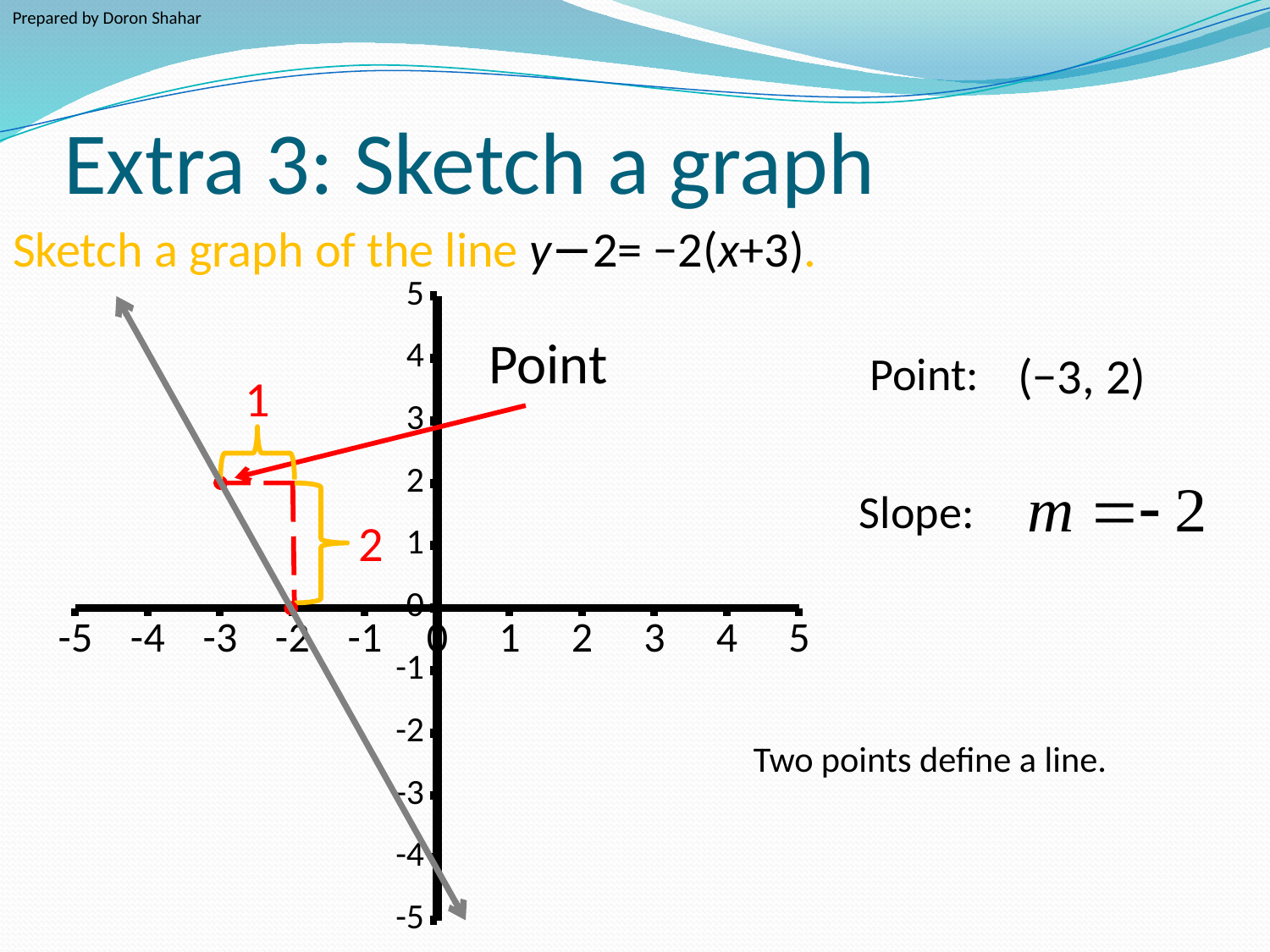
What is the slope of the line shown on the graph? m = −2 What is the range of values shown on the x-axis? −5 to 5 What kind of chart is shown on the slide? line graph At what x-value does the line cross the x-axis? −2 At x = −4, is the line's y-value greater or less than 3? greater Does the line rise or fall as x increases? falls At x = 0, is the line's y-value greater or less than 0? less What are the coordinates of the point labeled on the graph? (−3, 2) What number labels the horizontal run shown next to the marked point? 1 What is the y-value of the marked point at x = −3? 2 What number labels the vertical rise shown next to the marked point? 2 What is the equation of the line being sketched? y − 2 = −2(x + 3)